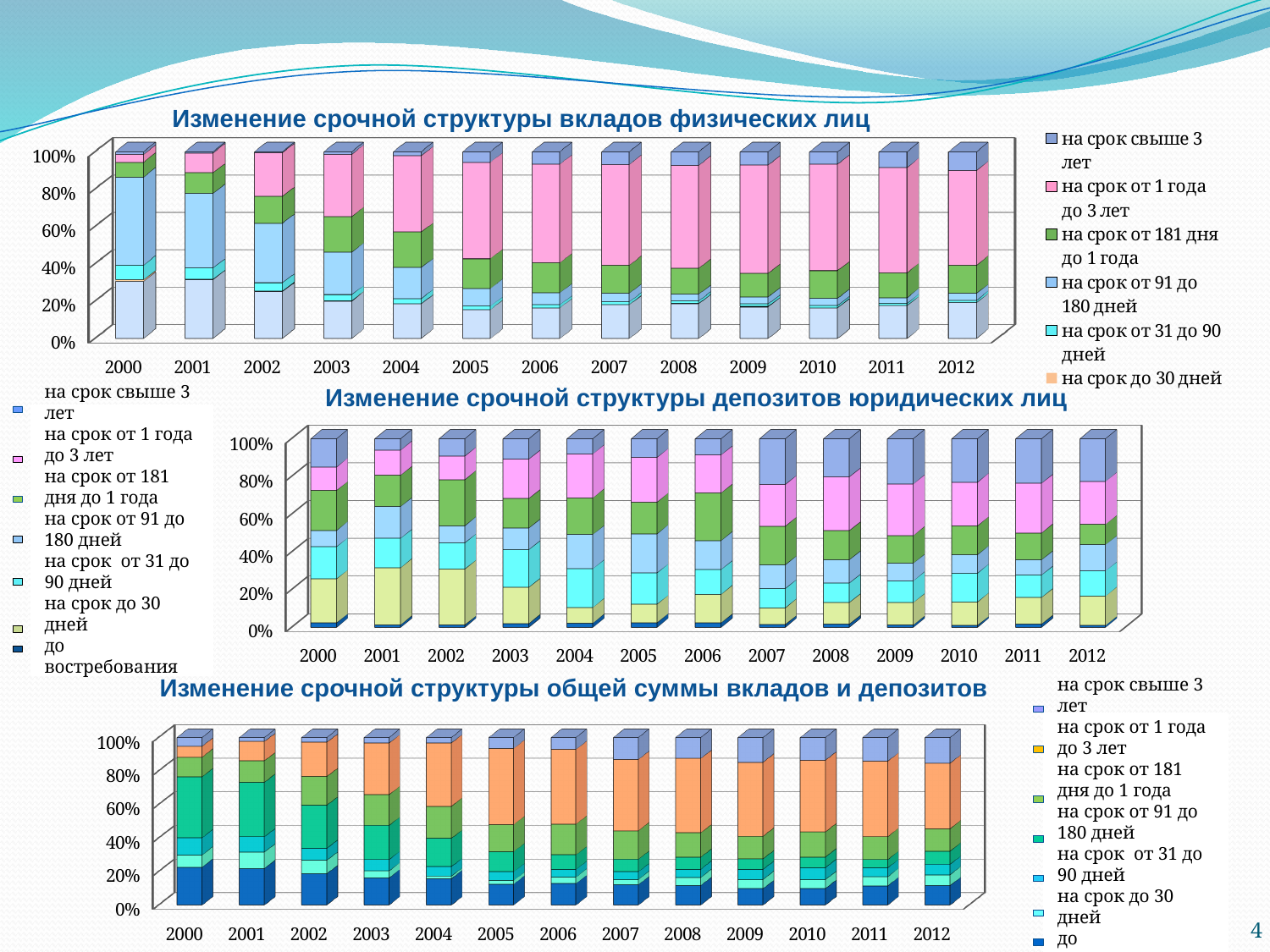
What kind of chart is the top chart titled "Изменение срочной структуры вкладов физических лиц"? stacked bar chart In the top chart "Изменение срочной структуры вкладов физических лиц", how many years are shown on the x axis? 13 In the top chart "Изменение срочной структуры вкладов физических лиц", does the share of "на срок от 1 года до 3 лет" rise or fall from 2000 to 2012? rise In the middle chart "Изменение срочной структуры депозитов юридических лиц", is the share of "до востребования" in 2000 greater or less than 20%? less What is the title of the middle chart on the slide? Изменение срочной структуры депозитов юридических лиц In the middle chart "Изменение срочной структуры депозитов юридических лиц", does the share of "на срок до 30 дней" rise or fall from 2000 to 2012? fall How many series does the legend of the middle chart "Изменение срочной структуры депозитов юридических лиц" list? 7 In the middle chart "Изменение срочной структуры депозитов юридических лиц", what is the first year shown on the x axis? 2000 In the bottom chart "Изменение срочной структуры общей суммы вкладов и депозитов", how many years are shown on the x axis? 13 In the bottom chart "Изменение срочной структуры общей суммы вкладов и депозитов", what is the last year shown on the x axis? 2012 What kind of chart is the bottom chart "Изменение срочной структуры общей суммы вкладов и депозитов"? stacked bar chart How many series does the legend of the top chart "Изменение срочной структуры вкладов физических лиц" list? 6